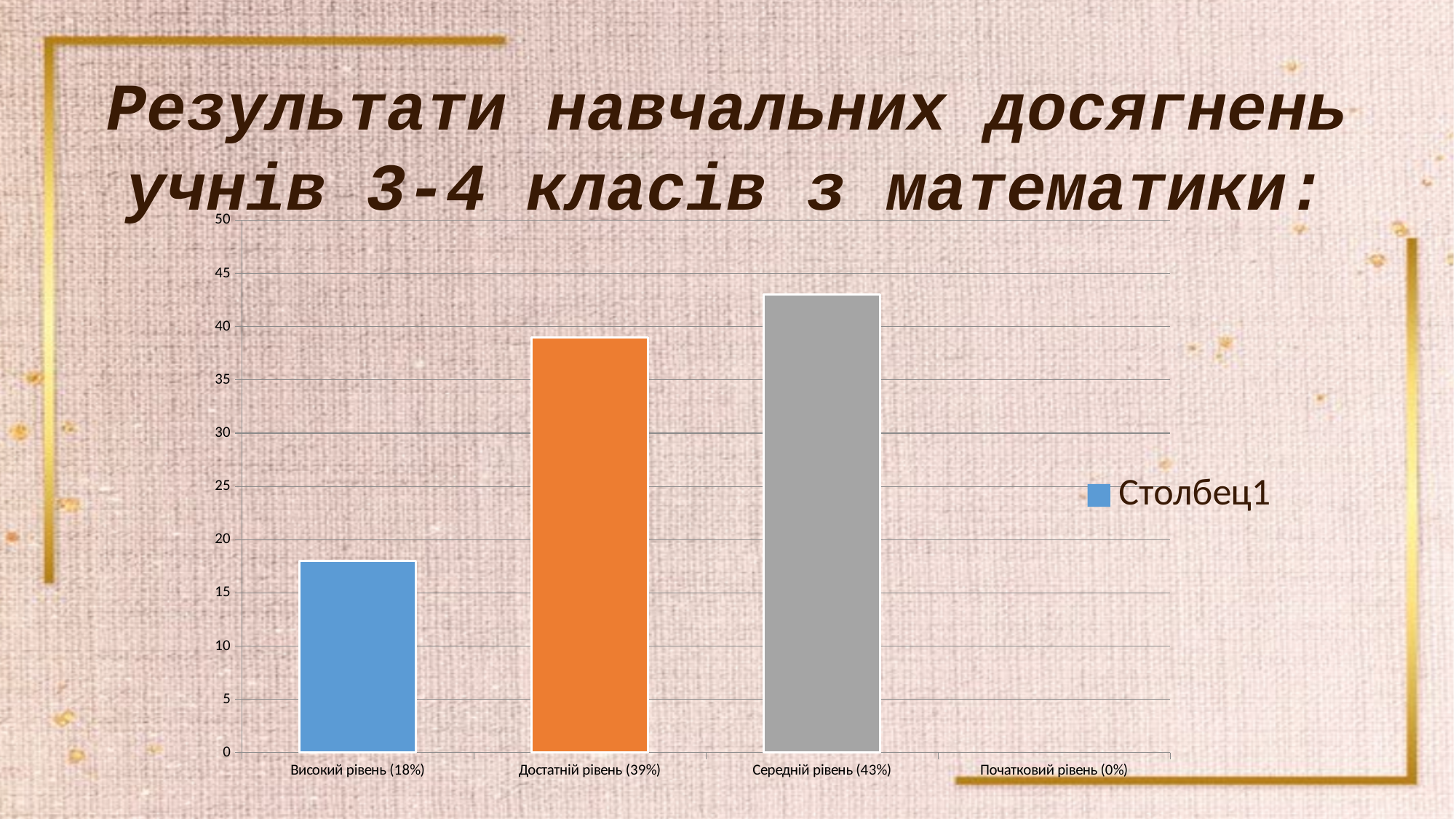
How many categories are shown on the x axis of the chart? 4 What kind of chart is shown on the slide? bar chart Which category has the lowest value? Початковий рівень How many series does the chart legend list? 1 Which category has the highest bar? Середній рівень What is the name of the series shown in the chart legend? Столбец1 What is the difference between the values for Середній рівень and Достатній рівень? 4% What value is printed for Високий рівень? 18% What value is printed for Достатній рівень? 39% What value is printed for Початковий рівень? 0% Is the bar for Достатній рівень greater or less than 35? greater What value is printed for Середній рівень? 43%